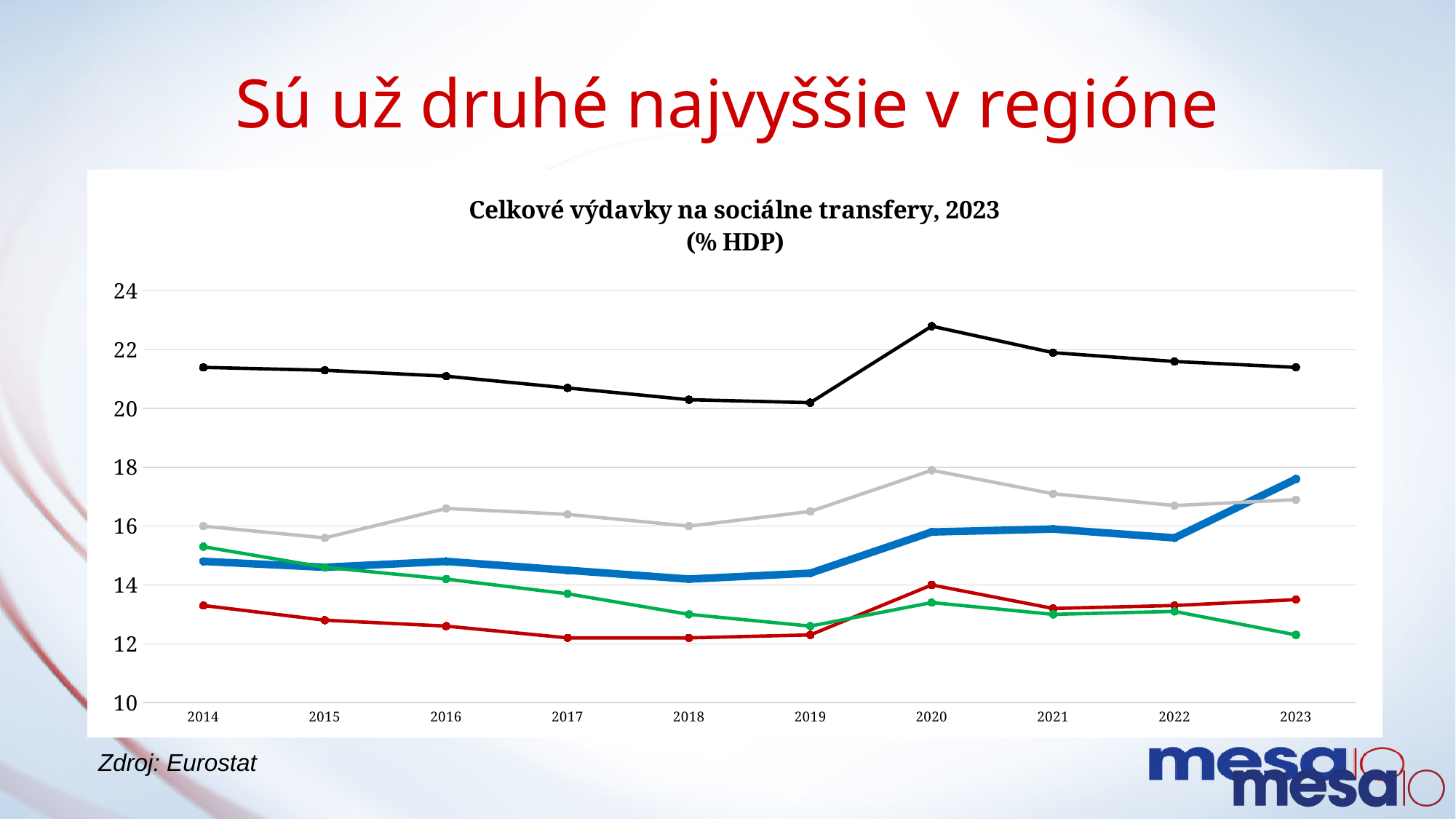
Is the value of the black line in 2020 greater or less than 22? greater Is the value of the red line in 2017 greater or less than 14? less What is the title of the chart? Celkové výdavky na sociálne transfery, 2023 (% HDP) Which line has the lowest value in 2023? the green line Is the value of the blue line in 2023 greater or less than 16? greater How many years are shown on the x axis of the chart? 10 Does the blue line rise or fall between 2022 and 2023? rise In which year does the black line reach its highest value? 2020 What kind of chart is shown on the slide? line chart In 2023, which is higher: the blue line or the grey line? the blue line Does the black line rise or fall between 2014 and 2019? fall